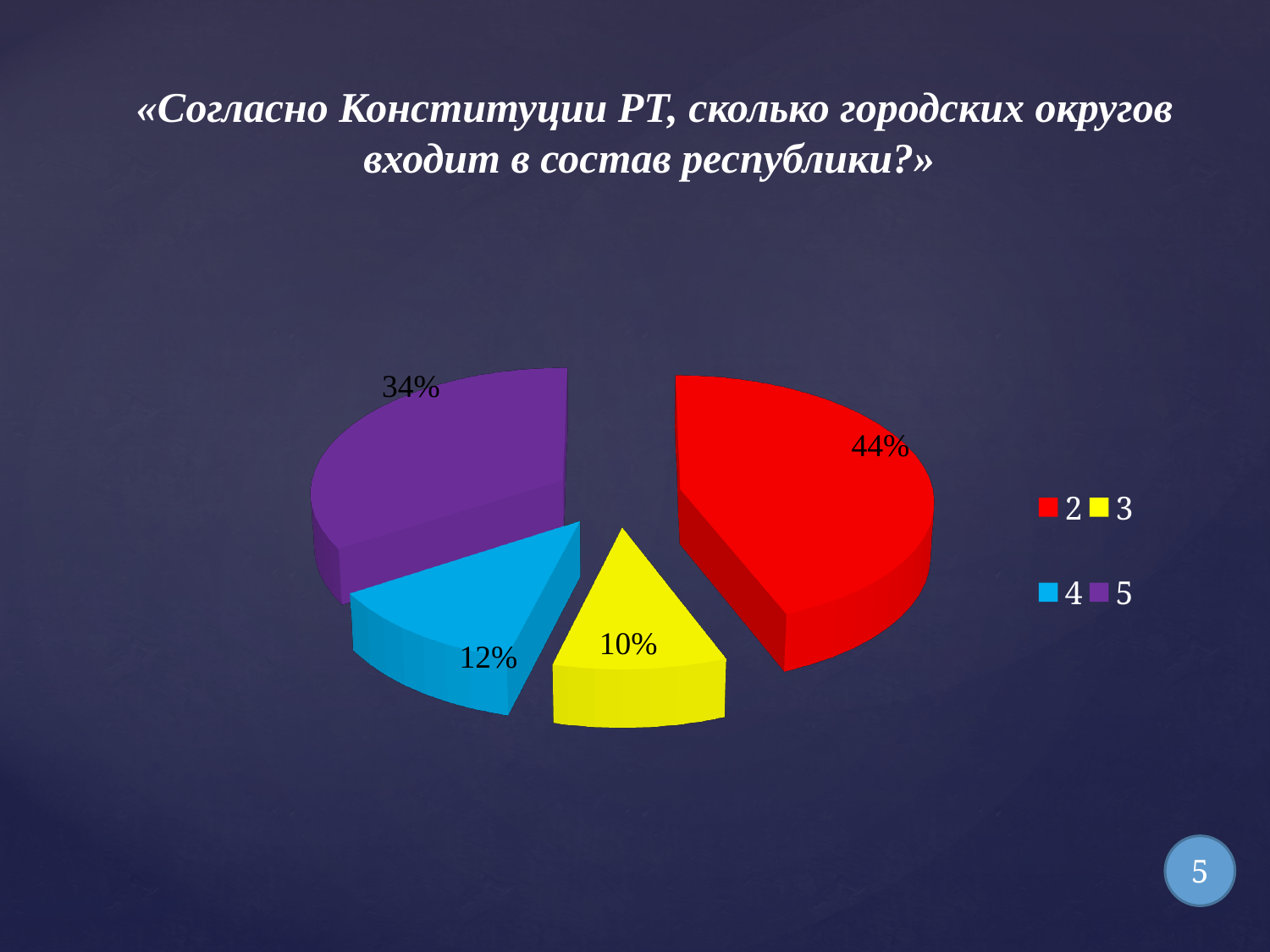
What kind of chart is shown on the slide? pie chart What share of the pie does the answer "2" have? 44% Which has a larger share, answer "4" or answer "3"? 4 How many slices does the pie chart have? 4 What share of the pie does the answer "5" have? 34% How many entries does the legend list? 4 What colour is the slice for answer "5"? purple Which answer has the smallest share of the pie? 3 Which answer has the largest share of the pie? 2 What is the difference between the shares for answers "2" and "5"? 10% What share of the pie does the answer "3" have? 10%